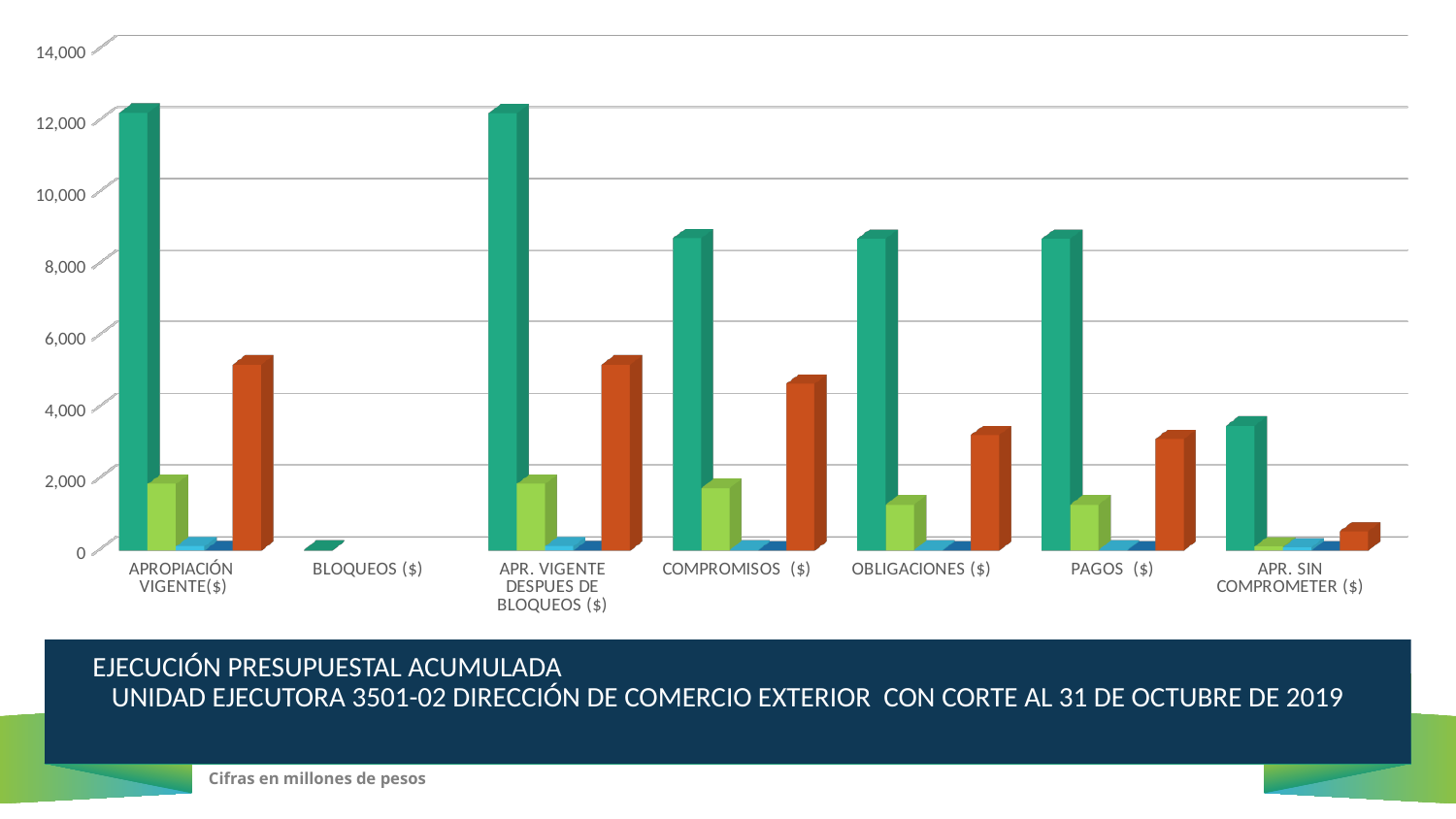
Is the value of the orange bar for OBLIGACIONES ($) greater or less than 4,000? less Is the value of the orange bar for APR. SIN COMPROMETER ($) greater or less than 2,000? less How many categories are shown along the x axis of the chart? 7 Which has the taller teal bar: APROPIACIÓN VIGENTE($) or COMPROMISOS ($)? APROPIACIÓN VIGENTE($) Which has the taller teal bar: COMPROMISOS ($) or APR. SIN COMPROMETER ($)? COMPROMISOS ($) Is the value of the tallest (teal) bar for APROPIACIÓN VIGENTE($) greater or less than 10,000? greater Which category has the lowest teal bar? BLOQUEOS ($) What kind of chart is shown on the slide? Bar chart According to the note below the chart, in what units are the figures expressed? Millones de pesos